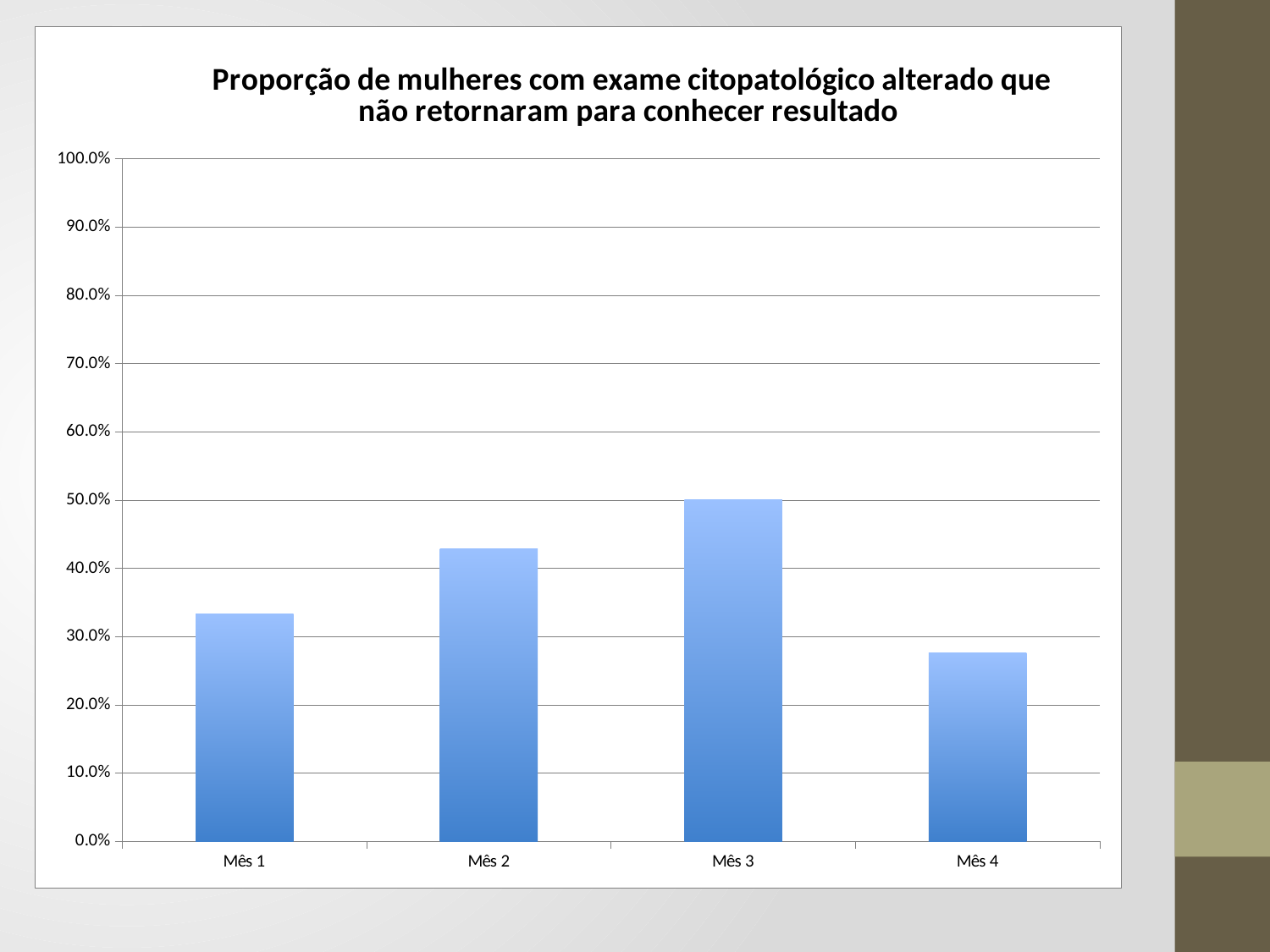
How many categories (months) are shown on the x axis? 4 What is the title of the chart? Proporção de mulheres com exame citopatológico alterado que não retornaram para conhecer resultado Does the value rise or fall from Mês 3 to Mês 4? fall Is the value for Mês 3 greater or less than 40.0%? greater What kind of chart is shown on the slide? bar chart Which month has the highest proportion? Mês 3 Is the value for Mês 2 greater or less than 40.0%? greater Is the value for Mês 1 greater or less than 30.0%? greater Which is larger, the value for Mês 1 or the value for Mês 2? Mês 2 Which is larger, the value for Mês 4 or the value for Mês 1? Mês 1 Which month has the lowest proportion? Mês 4